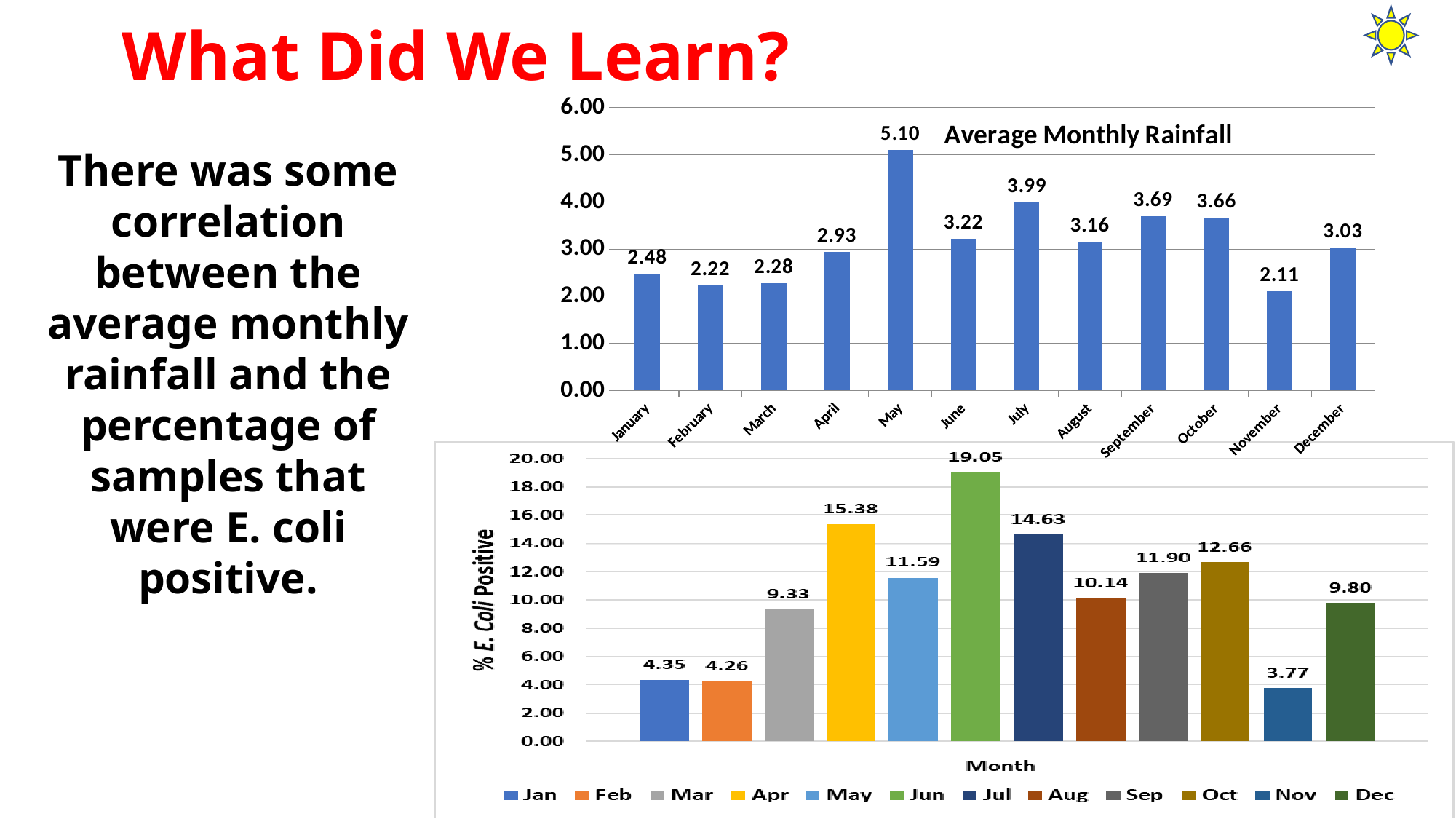
In the Average Monthly Rainfall chart, what is the difference between July and June? 0.77 In the Average Monthly Rainfall chart, which is larger, September or October? September In the Average Monthly Rainfall chart, which month has the lowest value? November In the bottom chart (% E. Coli Positive), what is the label on the x axis? Month What kind of chart is the Average Monthly Rainfall chart? bar chart In the bottom chart (% E. Coli Positive), which is larger, Jul or Oct? Jul In the bottom chart (% E. Coli Positive), how many entries does the legend list? 12 In the bottom chart (% E. Coli Positive), what is the difference between Apr and Mar? 6.05 In the bottom chart (% E. Coli Positive), what is the value for Jun? 19.05 In the Average Monthly Rainfall chart, what is the value for May? 5.10 In the bottom chart (% E. Coli Positive), which month has the lowest value? Nov In the Average Monthly Rainfall chart, how many months are plotted? 12